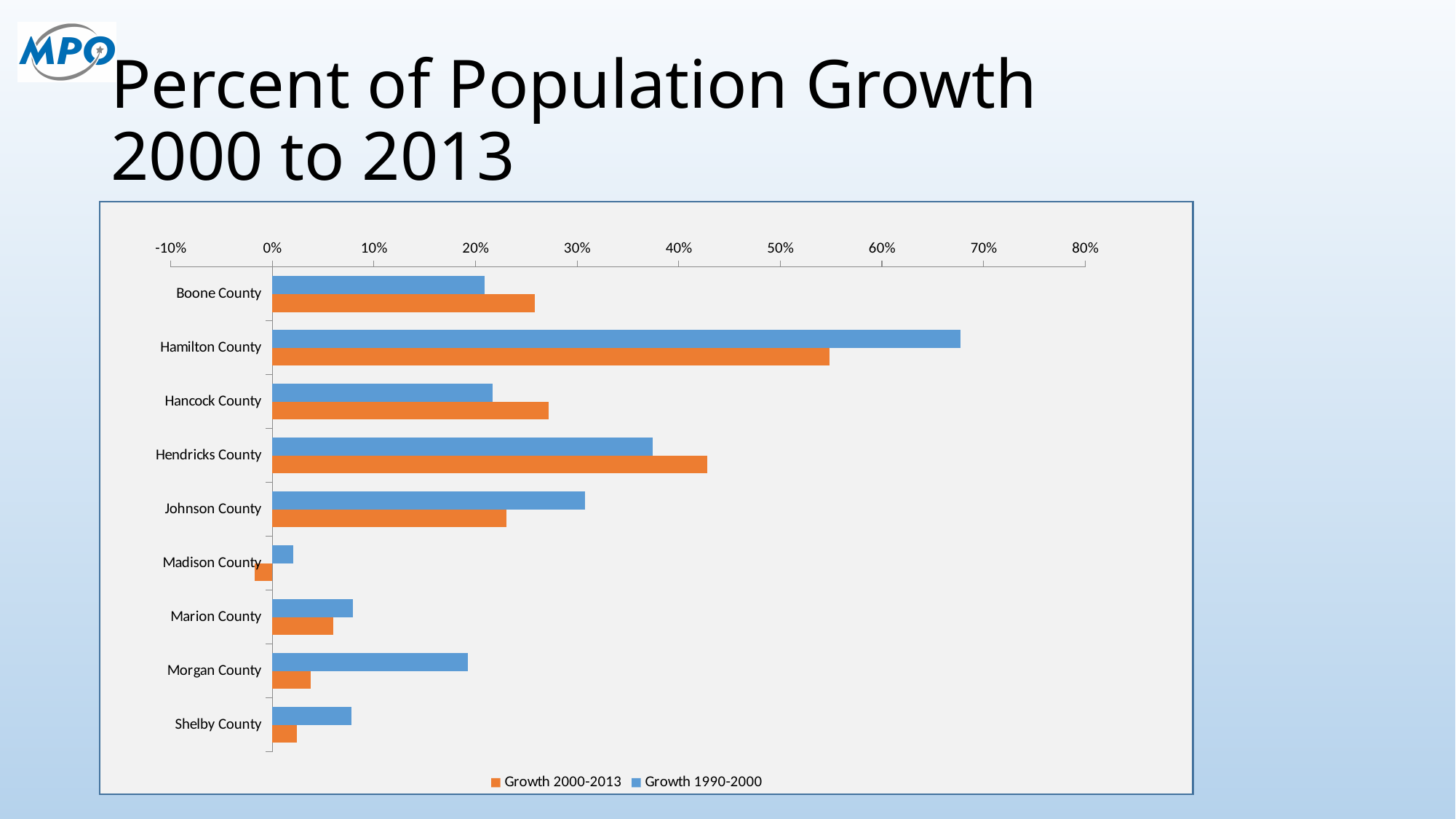
Which county has the lowest Growth 2000-2013 value? Madison County Which colour represents the Growth 2000-2013 series in the legend? orange Is the Growth 1990-2000 value for Hamilton County greater or less than 60%? greater Is the Growth 2000-2013 value for Morgan County greater or less than 10%? less What kind of chart is shown on the slide? bar chart Which county has the highest Growth 2000-2013 value? Hamilton County How many series does the legend list? 2 Is the Growth 2000-2013 value for Hendricks County greater or less than 40%? greater For Johnson County, which series has the larger value, Growth 2000-2013 or Growth 1990-2000? Growth 1990-2000 How many counties are listed on the chart? 9 Which county has the highest Growth 1990-2000 value? Hamilton County Which county has the lowest Growth 1990-2000 value? Madison County